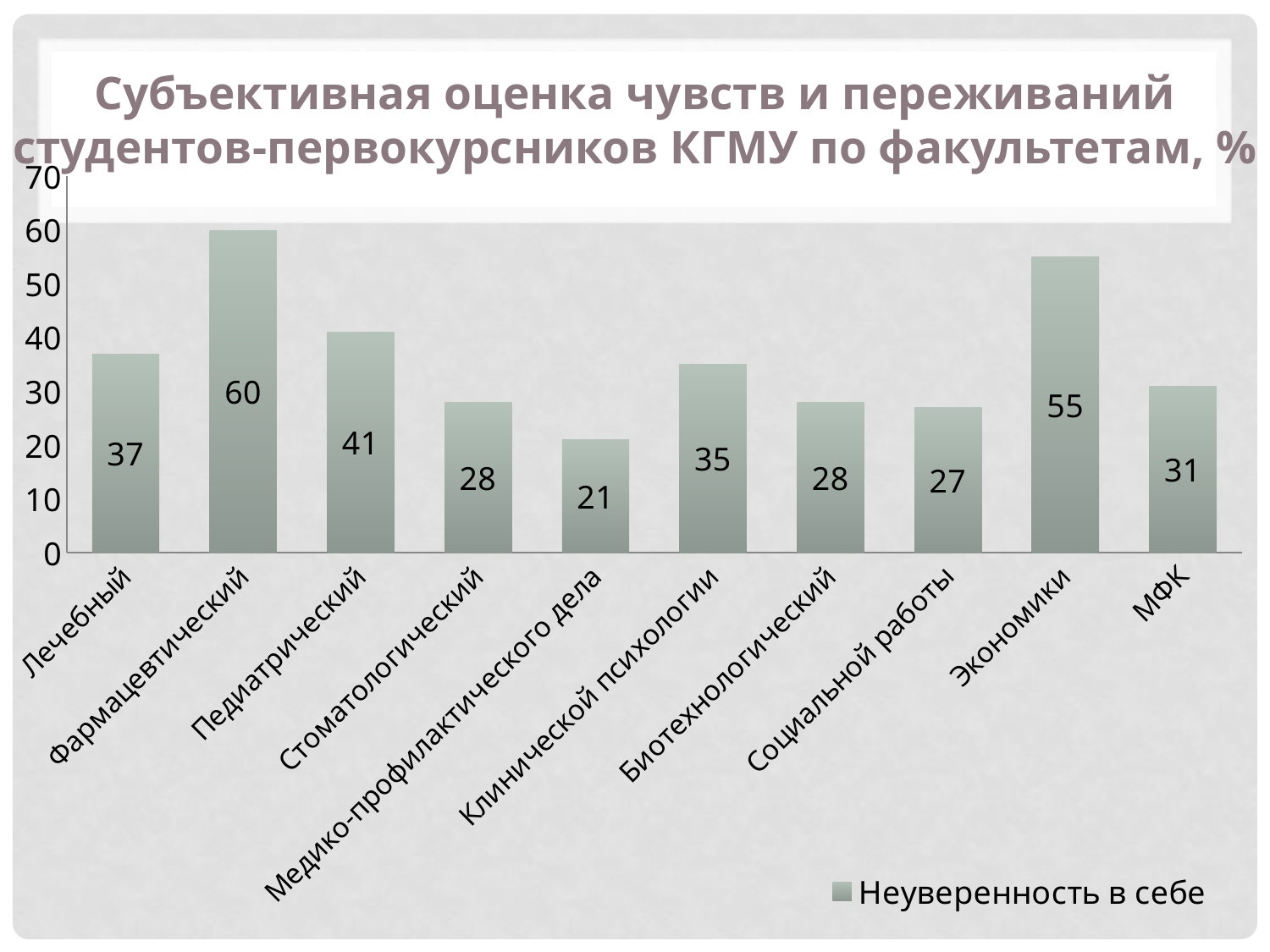
Is the value for Экономики greater or less than 50? greater What is the legend entry of the series? Неуверенность в себе What is the value for Фармацевтический? 60 How many series does the legend list? 1 Which is larger, the value for Педиатрический or the value for Клинической психологии? Педиатрический Which faculty has the lowest value? Медико-профилактического дела What is the difference between the values for Фармацевтический and Лечебный? 23 Which faculty has the highest value? Фармацевтический What is the value for Медико-профилактического дела? 21 What kind of chart is this? bar chart How many faculties are shown on the x axis? 10 What is the value for Экономики? 55